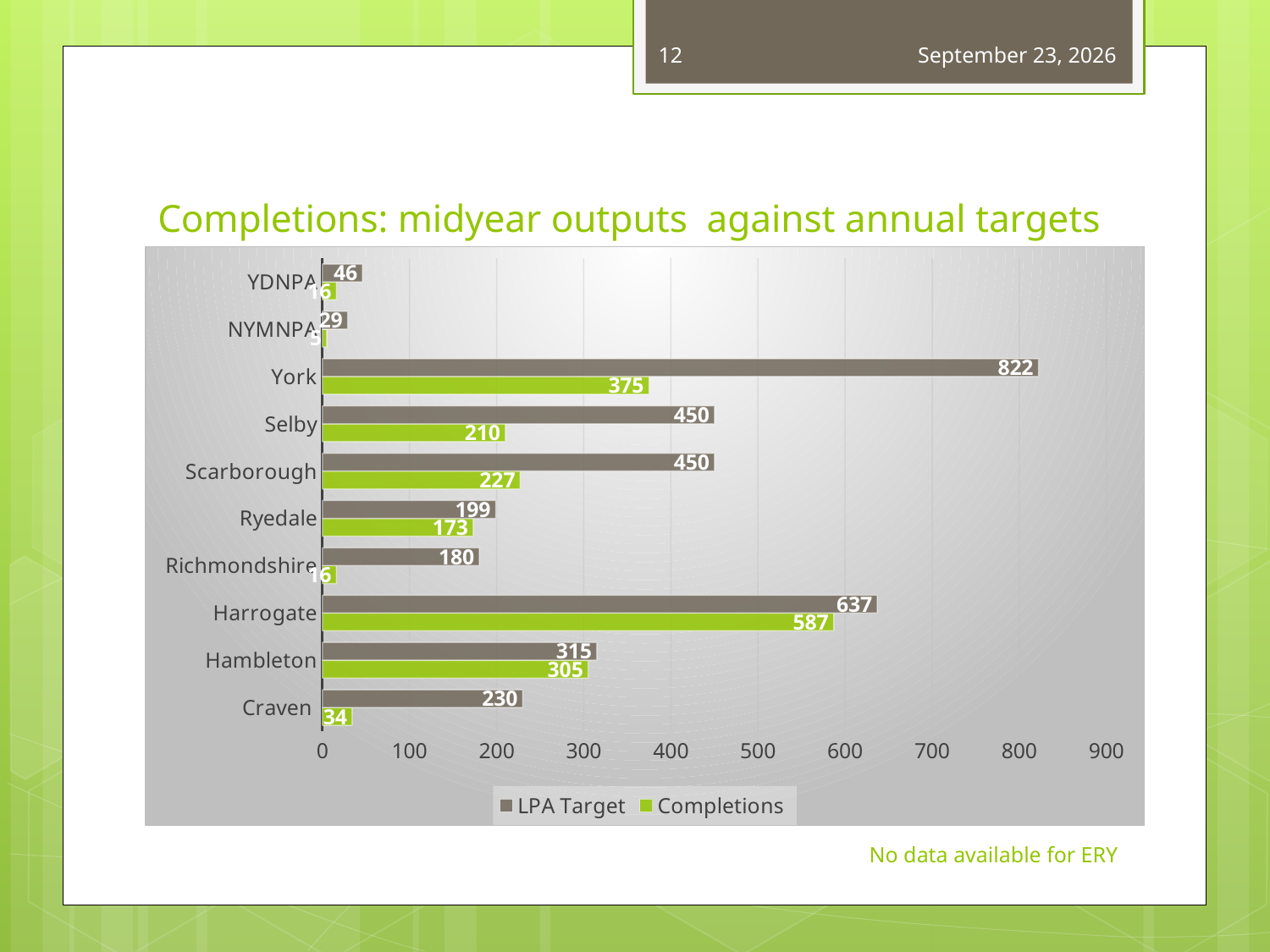
How many series does the legend list? 2 What is the Completions value for Ryedale? 173 How many categories are shown on the chart? 10 Which has the larger Completions value, Selby or Scarborough? Scarborough What is the Completions value for Harrogate? 587 What is the difference between the LPA Target and Completions for Hambleton? 10 What is the LPA Target value for York? 822 Is the Completions value for Richmondshire greater or less than 100? less Which category has the lowest LPA Target? NYMNPA Which category has the highest LPA Target? York What is the difference between the LPA Target and Completions for York? 447 What kind of chart is shown on the slide? bar chart